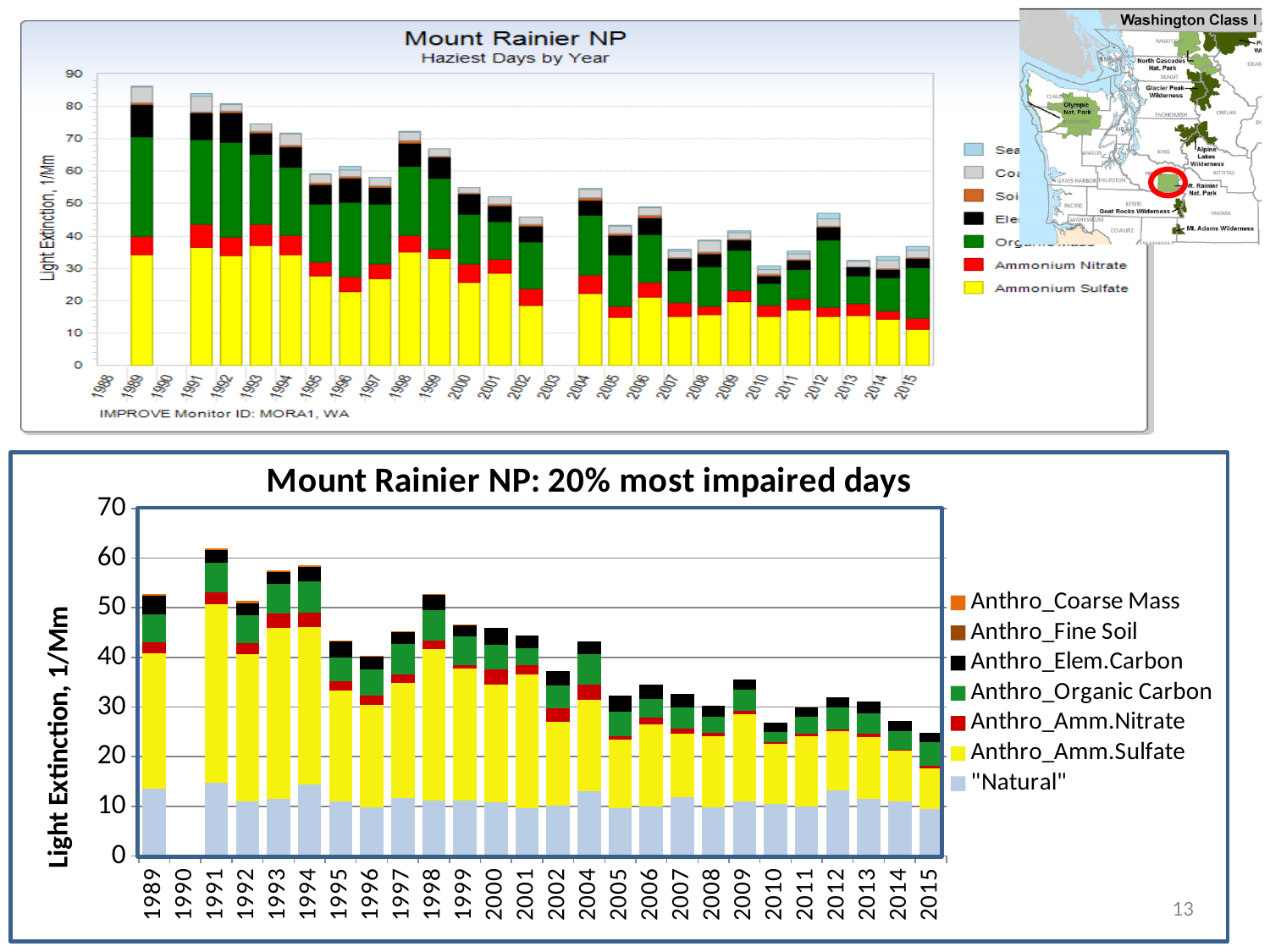
In the bottom chart ("20% most impaired days"), is the total bar height for 2010 greater or less than 30? less In the top chart ("Mount Rainier NP Haziest Days by Year"), is the total bar height for 1989 greater or less than 80? greater How many series does the legend of the bottom chart ("20% most impaired days") list? 7 In the top chart ("Mount Rainier NP Haziest Days by Year"), which year has a taller total bar, 1998 or 2007? 1998 In the bottom chart ("20% most impaired days"), do the total bar heights generally rise or fall from 1989 to 2015? Fall What is the y-axis label of the bottom chart ("20% most impaired days")? Light Extinction, 1/Mm In the top chart ("Mount Rainier NP Haziest Days by Year"), is the total bar height for 2010 greater or less than 40? less In the bottom chart ("20% most impaired days"), which year has the tallest stacked bar? 1991 What kind of chart is the bottom chart titled "Mount Rainier NP: 20% most impaired days"? Stacked bar chart In the bottom chart ("20% most impaired days"), which year has a taller total bar, 1991 or 2015? 1991